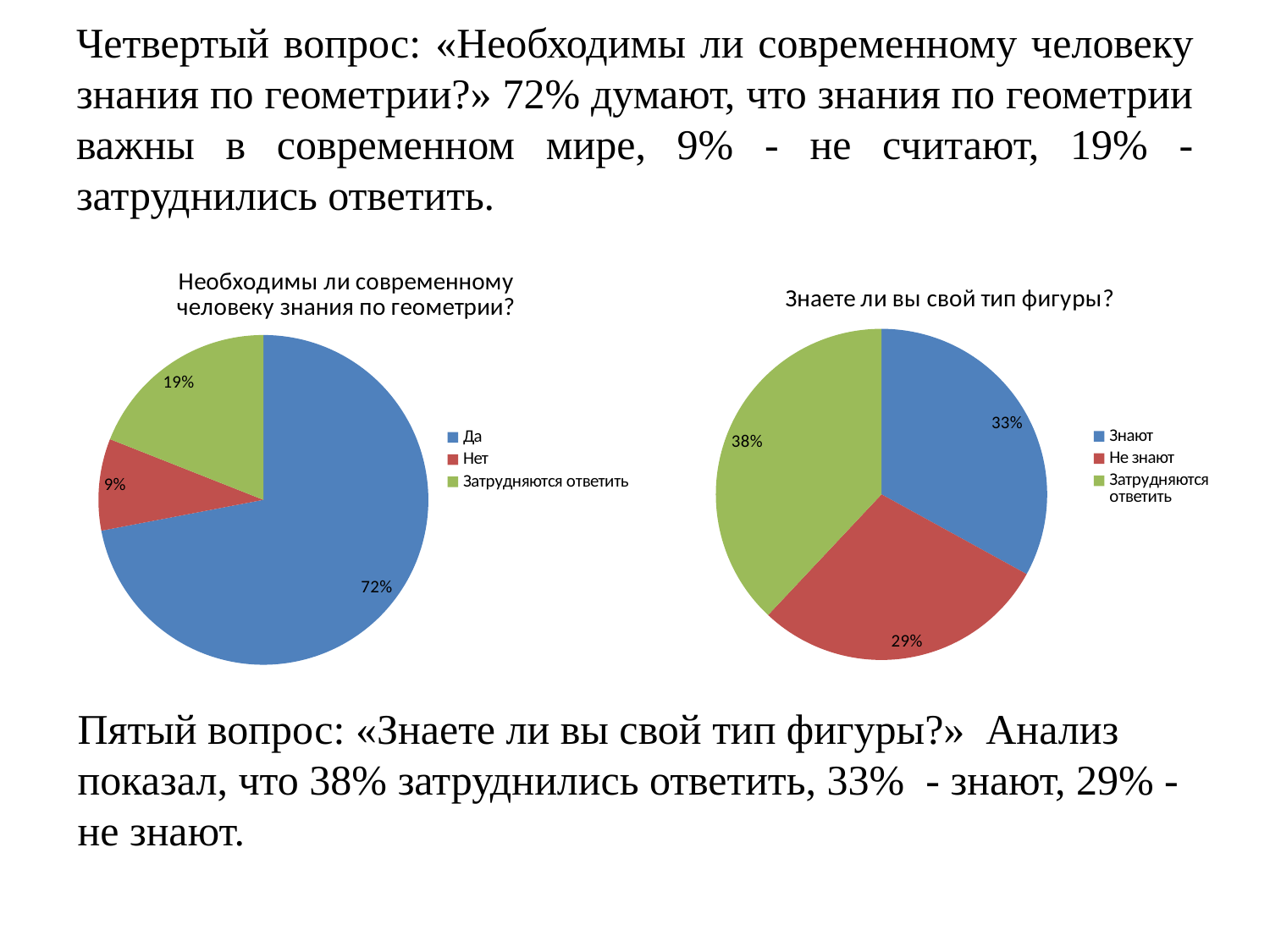
In the left pie chart 'Необходимы ли современному человеку знания по геометрии?', which category has the largest slice? Да In the right pie chart 'Знаете ли вы свой тип фигуры?', what share is labelled for 'Не знают'? 29% In the right pie chart 'Знаете ли вы свой тип фигуры?', what share is labelled for 'Затрудняются ответить'? 38% In the left pie chart 'Необходимы ли современному человеку знания по геометрии?', what colour is the 'Затрудняются ответить' slice? Green In the left pie chart 'Необходимы ли современному человеку знания по геометрии?', which category has the smallest slice? Нет What type of chart is the left chart 'Необходимы ли современному человеку знания по геометрии?'? Pie chart In the right pie chart 'Знаете ли вы свой тип фигуры?', which category has the largest slice? Затрудняются ответить In the left pie chart 'Необходимы ли современному человеку знания по геометрии?', what share is labelled for 'Нет'? 9% In the left pie chart 'Необходимы ли современному человеку знания по геометрии?', what is the difference in percentage points between 'Да' and 'Затрудняются ответить'? 53 In the right pie chart 'Знаете ли вы свой тип фигуры?', how many categories does the legend list? 3 In the left pie chart 'Необходимы ли современному человеку знания по геометрии?', what share is labelled for 'Да'? 72% In the right pie chart 'Знаете ли вы свой тип фигуры?', which is larger, 'Знают' or 'Не знают'? Знают